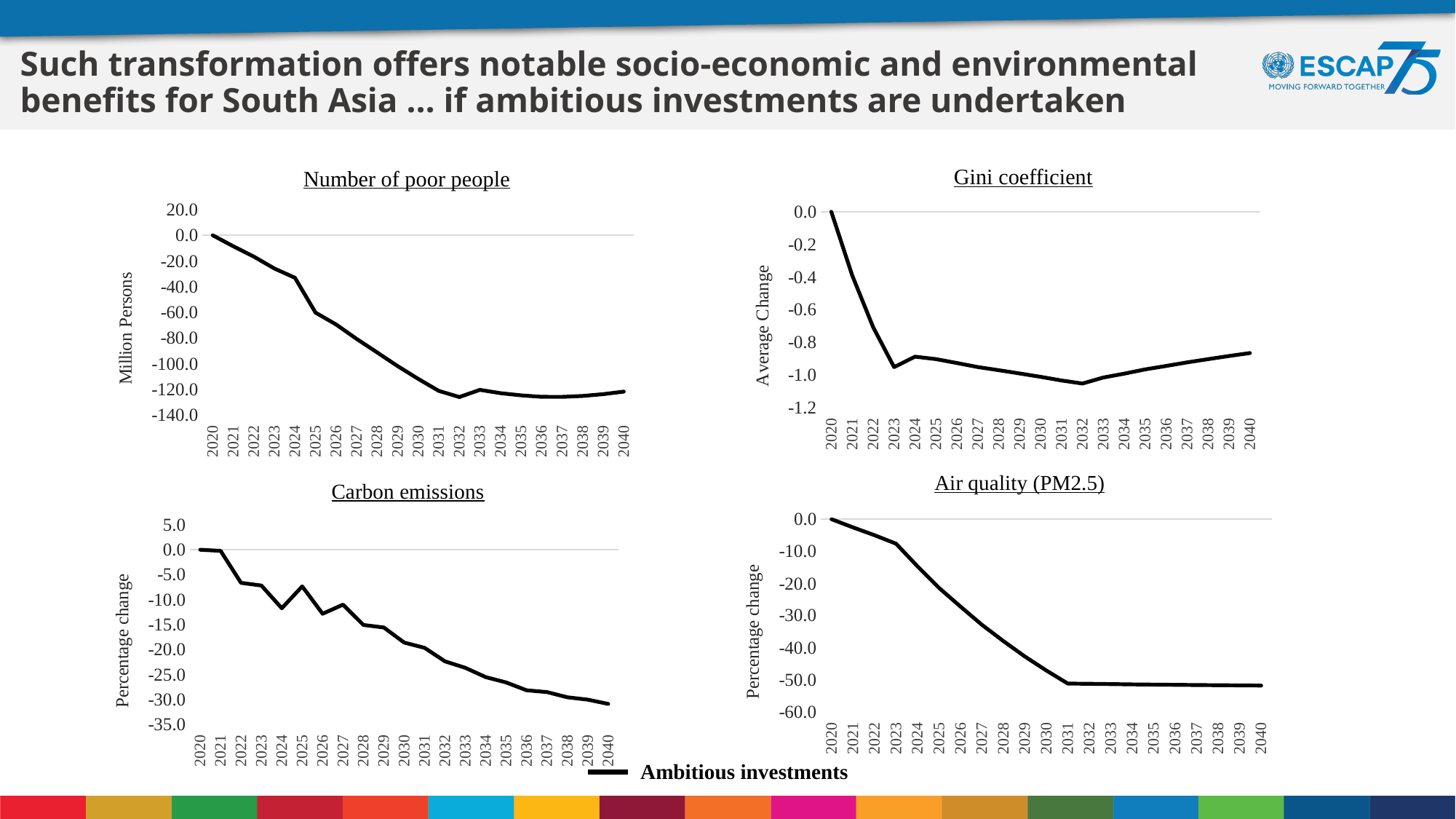
In the 'Gini coefficient' chart, which year has the lowest value? 2032 In the 'Gini coefficient' chart, is the value for 2040 greater or less than -1.0? greater What is the y-axis label of the 'Number of poor people' chart? Million Persons In the 'Number of poor people' chart, is the value for 2040 greater or less than -100.0? less In the 'Carbon emissions' chart, is the value for 2040 greater or less than -25.0? less In the 'Carbon emissions' chart, do the values generally rise or fall from 2020 to 2040? fall How many series does the legend at the bottom of the slide list? 1 What kind of chart is the 'Number of poor people' chart? line chart How many years are plotted on the x axis of the 'Gini coefficient' chart? 21 In the 'Number of poor people' chart, what is the value for 2020? 0.0